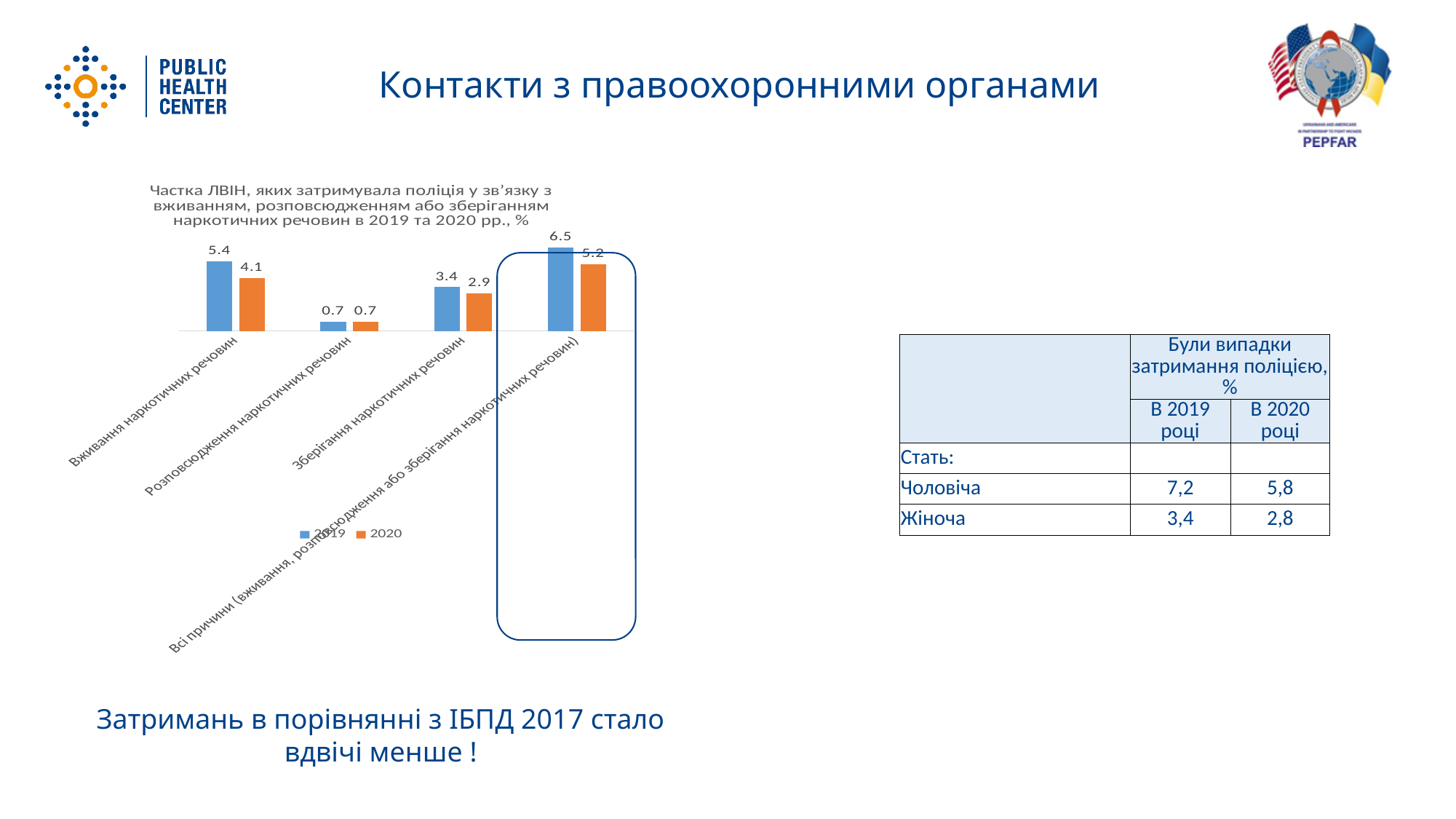
What is the difference between the 2019 and 2020 values for "Всі причини"? 1.3 What is the 2020 value for "Вживання наркотичних речовин"? 4.1 How many series does the chart legend list? 2 What is the 2020 value for "Зберігання наркотичних речовин"? 2.9 Which series is shown in orange in the chart legend? 2020 What is the 2019 value for "Вживання наркотичних речовин"? 5.4 What is the 2019 value for "Всі причини"? 6.5 How many categories are shown on the chart's x axis? 4 Which is larger for "Зберігання наркотичних речовин": the 2019 value or the 2020 value? 2019 What type of chart is shown on the slide? Bar chart Which category has the lowest 2020 value? Розповсюдження наркотичних речовин Which category has the highest 2019 value? Всі причини (вживання, розповсюдження або зберігання наркотичних речовин)